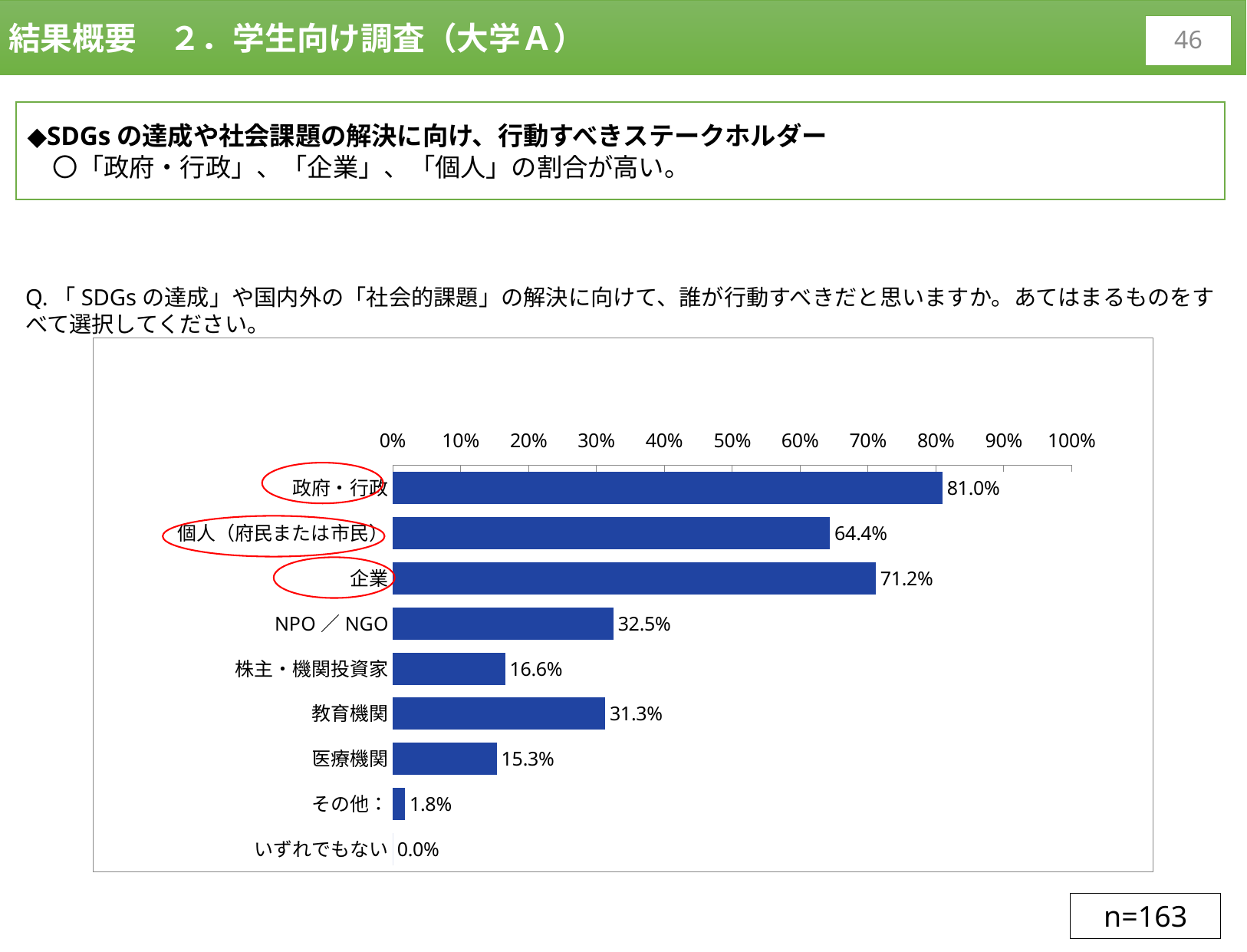
What kind of chart is shown on the slide? bar chart Which is larger, the value for 個人（府民または市民） or the value for 企業? 企業 What is the sample size (n) shown on the slide? n=163 What is the value for 医療機関? 15.3% Is the value for 教育機関 greater or less than 40%? less How many categories are shown in the chart? 9 What is the value for 企業? 71.2% What is the value for 政府・行政? 81.0% What is the value for NPO／NGO? 32.5% Which category has the lowest value? いずれでもない Which category has the highest value? 政府・行政 What is the difference between the values for 政府・行政 and 企業? 9.8%